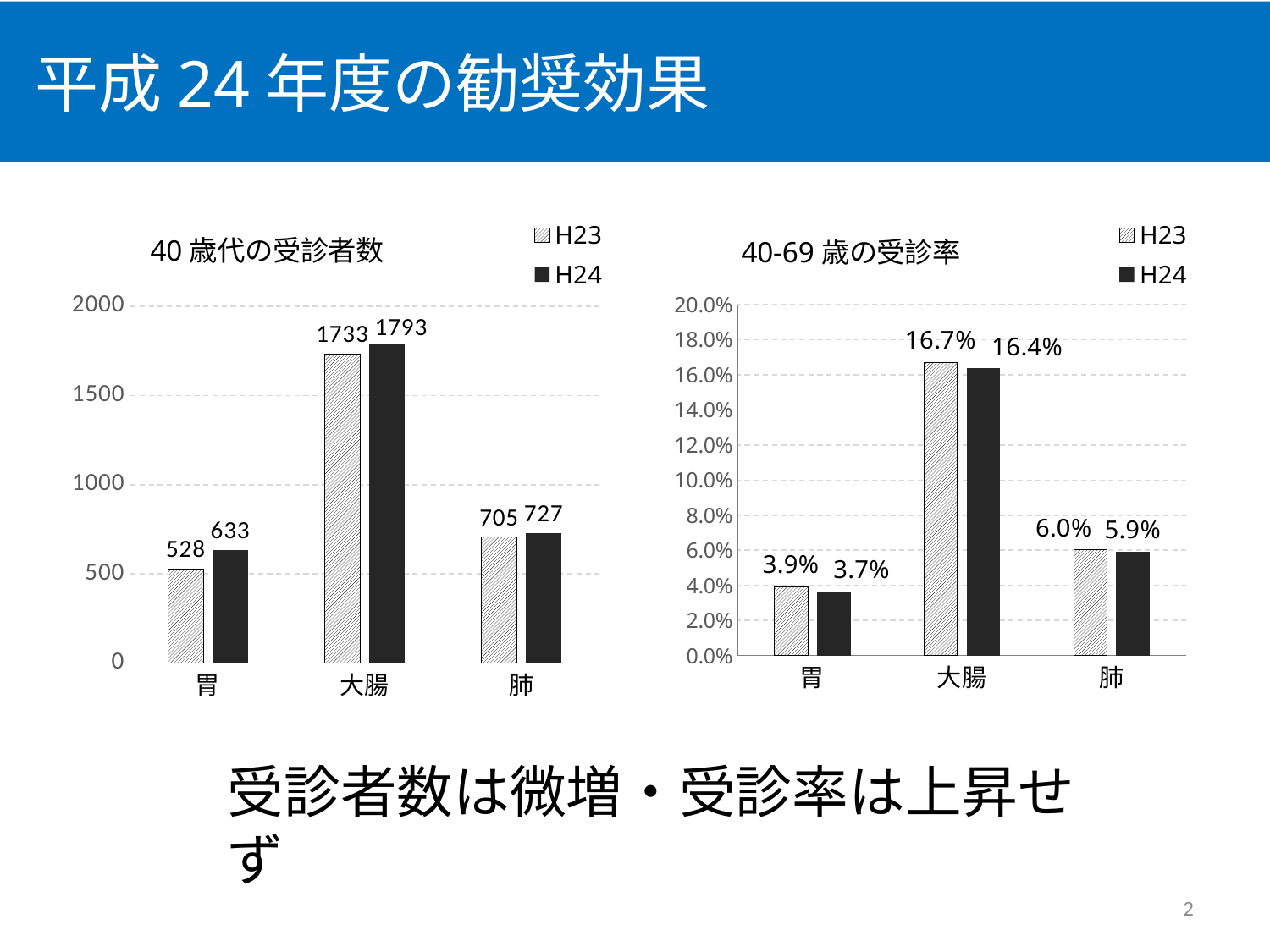
In the chart titled 40-69歳の受診率, what is the H23 value for 大腸? 16.7% In the chart titled 40-69歳の受診率, which category has the lowest H23 value? 胃 In the chart titled 40-69歳の受診率, which is larger for 大腸: the H23 value or the H24 value? H23 In the chart titled 40歳代の受診者数, which category has the highest H24 value? 大腸 In the chart titled 40歳代の受診者数, what is the H23 value for 胃? 528 In the chart titled 40歳代の受診者数, how many categories are shown on the x axis? 3 In the chart titled 40歳代の受診者数, what is the H24 value for 大腸? 1793 In the chart titled 40歳代の受診者数, what is the difference between the H24 and H23 values for 胃? 105 In the chart titled 40-69歳の受診率, what is the H24 value for 肺? 5.9% How many series does the legend of the chart titled 40-69歳の受診率 list? 2 In the chart titled 40-69歳の受診率, what is the difference between the H23 and H24 values for 大腸? 0.3% What kind of chart is the chart titled 40歳代の受診者数? bar chart